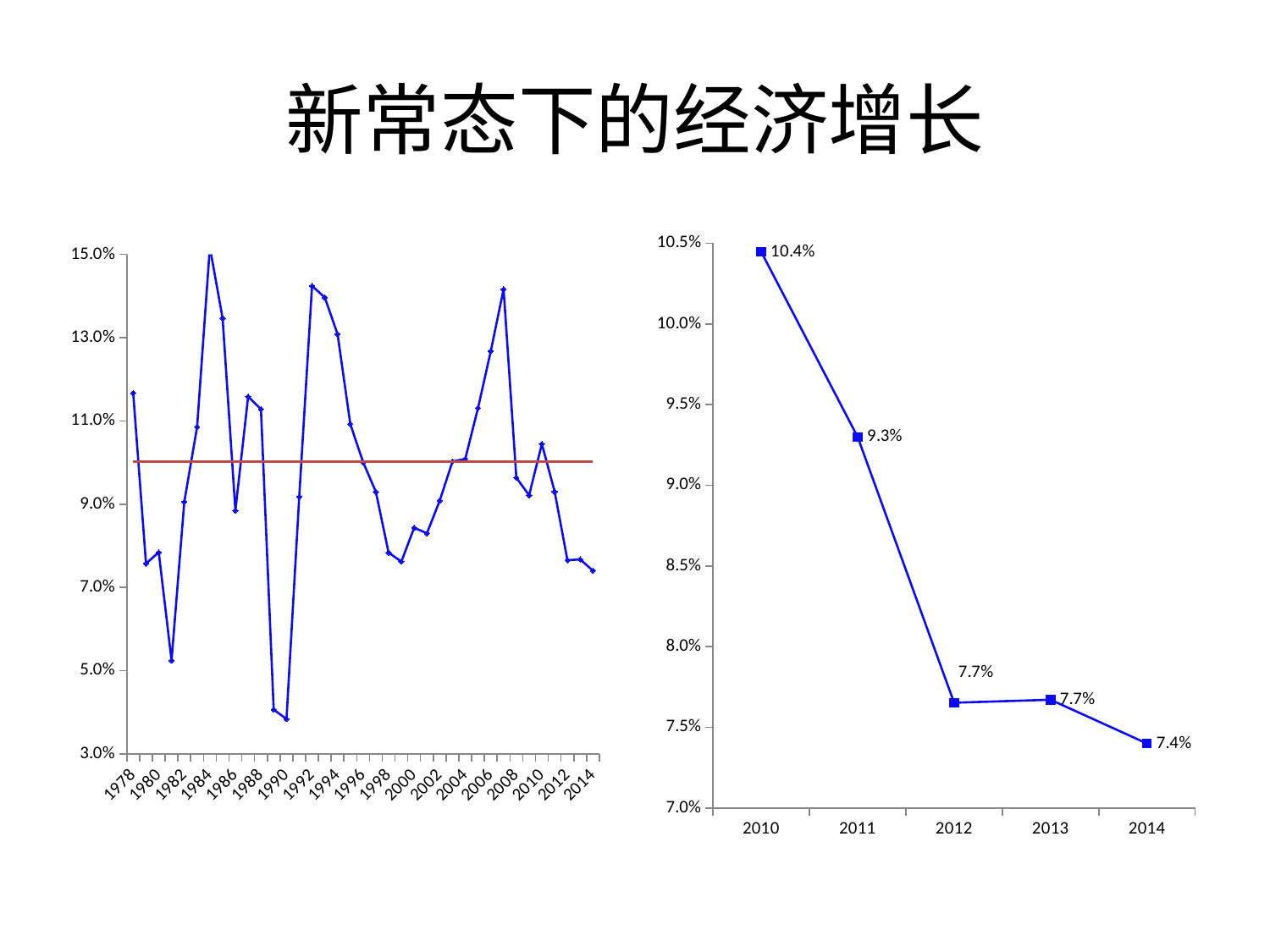
What kind of chart is the left chart? line chart On the right chart, what is the value for 2014? 7.4% On the right chart, which year has the lowest value? 2014 On the left chart, is the value for 1990 greater or less than 5.0%? less On the right chart, how many data points are plotted? 5 On the left chart, is the value for 1984 greater or less than 13.0%? greater On the right chart, do the values rise or fall from 2010 to 2014? fall On the right chart, what is the value for 2011? 9.3% On the right chart, what is the value for 2010? 10.4% On the right chart, what is the difference between the values for 2010 and 2014? 3.0 percentage points On the right chart, which year has the highest value? 2010 On the right chart, which is larger, the value for 2011 or the value for 2013? 2011